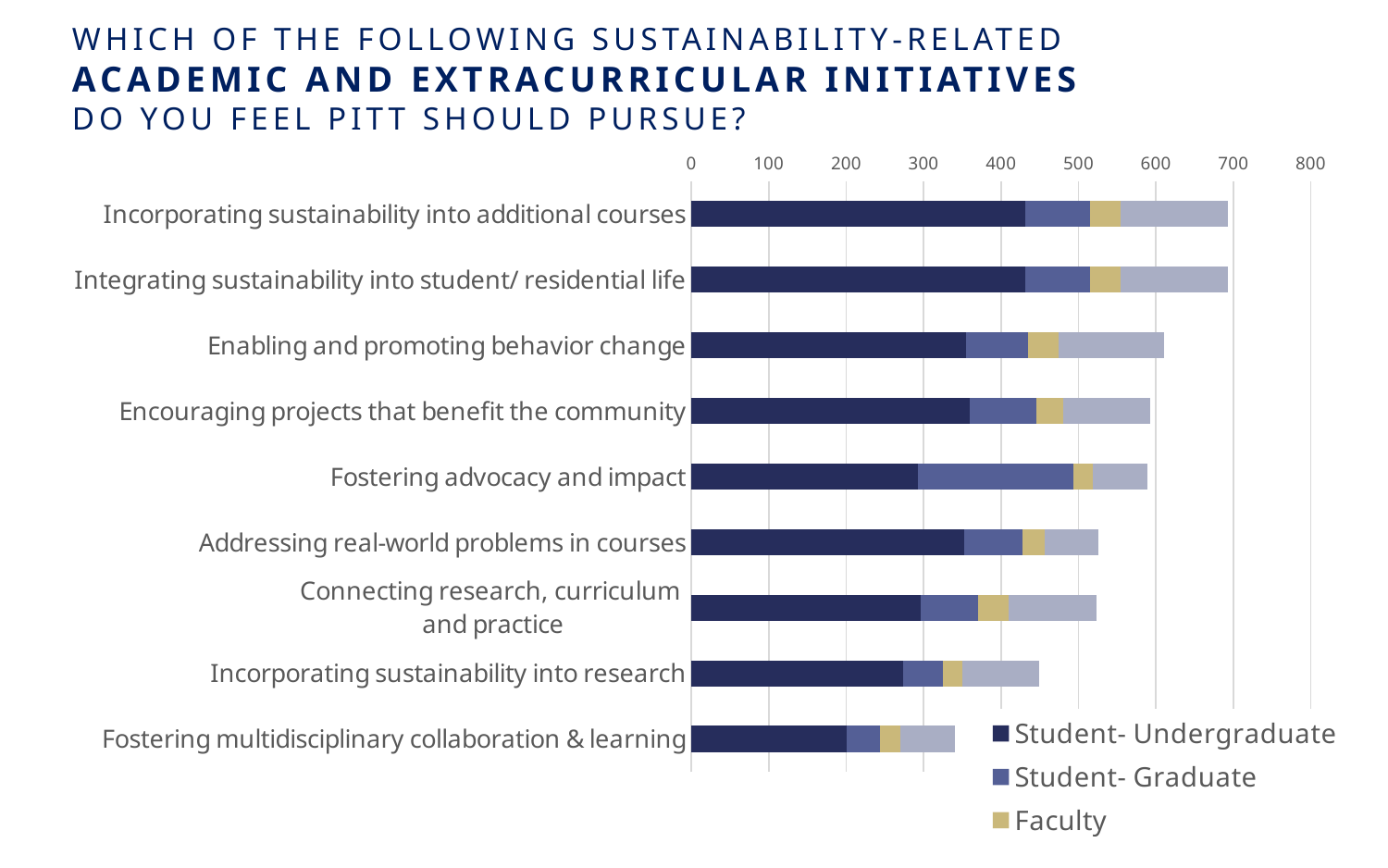
Is the Student- Undergraduate segment for 'Incorporating sustainability into additional courses' greater or less than 400? greater Which has the longer total bar: 'Enabling and promoting behavior change' or 'Incorporating sustainability into research'? Enabling and promoting behavior change Is the total bar for 'Enabling and promoting behavior change' greater or less than 500? greater Which series is shown in the darkest navy colour according to the legend? Student- Undergraduate How many series does the chart's legend list? 3 Which initiative has the shortest total bar? Fostering multidisciplinary collaboration & learning Do the total bar lengths increase or decrease going from the top initiative to the bottom initiative? Decrease Is the total bar for 'Incorporating sustainability into research' greater or less than 400? greater How many initiatives (categories) are plotted in the chart? 9 What kind of chart is shown on the slide? Stacked bar chart